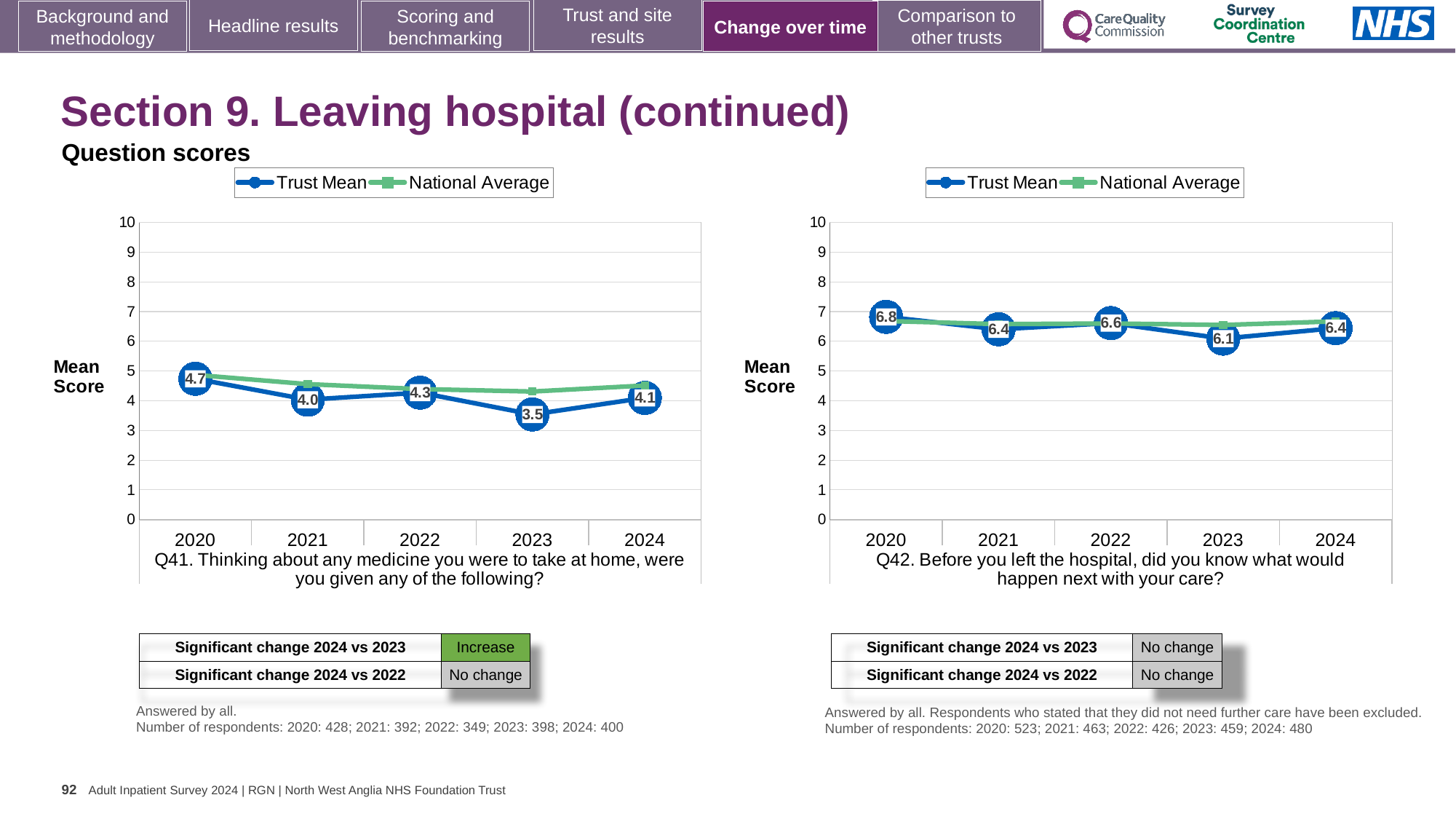
In the Q42 chart, what is the Trust Mean score for 2020? 6.8 How many series does the legend of the Q41 chart list? 2 In the Q42 chart, is the Trust Mean score higher in 2022 or in 2021? 2022 How many years are shown on the x axis of the Q42 chart? 5 What type of chart is used for Q41? Line chart In the Q41 chart, does the Trust Mean score rise or fall from 2020 to 2021? Fall In the Q42 chart, which year has the lowest Trust Mean score? 2023 In the Q41 chart, what is the difference between the Trust Mean scores for 2024 and 2023? 0.6 In the Q41 chart, is the National Average value for 2023 greater or less than 5? less In the Q41 chart, which year has the highest Trust Mean score? 2020 In the Q42 chart, what is the difference between the Trust Mean scores for 2020 and 2023? 0.7 In the Q41 chart, what is the Trust Mean score for 2023? 3.5